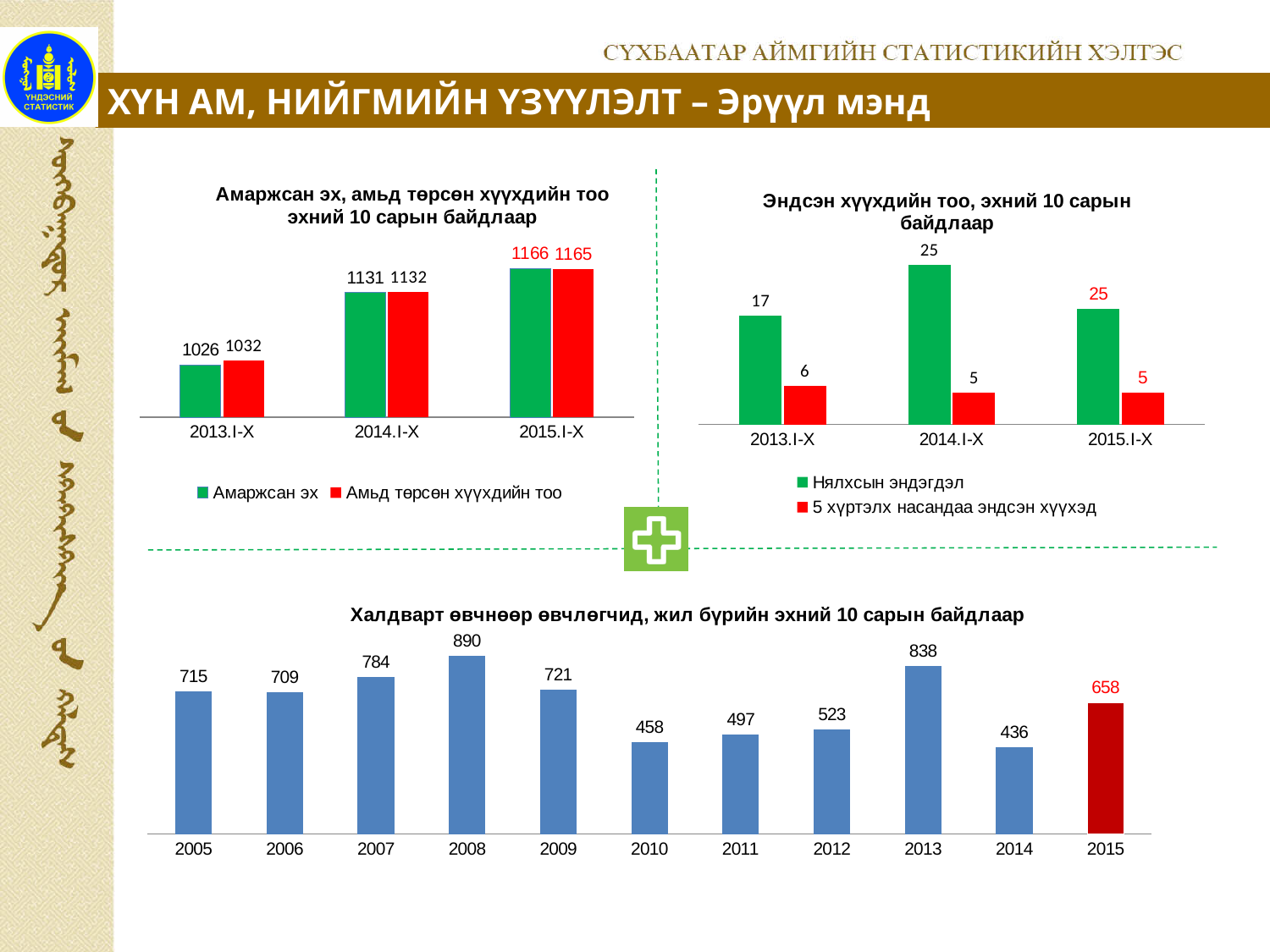
In the bottom chart (Халдварт өвчнөөр өвчлөгчид), what is the value for 2008? 890 In the top-right chart (Эндсэн хүүхдийн тоо), what is the value for Нялхсын эндэгдэл in 2013.I-X? 17 In the bottom chart (Халдварт өвчнөөр өвчлөгчид), how many years are shown on the x axis? 11 In the top-left chart (Амаржсан эх, амьд төрсөн хүүхдийн тоо), what is the value for Амаржсан эх in 2013.I-X? 1026 In the top-right chart (Эндсэн хүүхдийн тоо), what is the value for 5 хүртэлх насандаа эндсэн хүүхэд in 2014.I-X? 5 In the top-left chart (Амаржсан эх, амьд төрсөн хүүхдийн тоо), what is the value for Амьд төрсөн хүүхдийн тоо in 2015.I-X? 1165 What kind of chart is the bottom chart (Халдварт өвчнөөр өвчлөгчид)? Bar chart In the top-left chart (Амаржсан эх, амьд төрсөн хүүхдийн тоо), how many series does the legend list? 2 In the bottom chart (Халдварт өвчнөөр өвчлөгчид), which year has the highest value? 2008 In the bottom chart (Халдварт өвчнөөр өвчлөгчид), which year has the lowest value? 2014 In the top-right chart (Эндсэн хүүхдийн тоо), which period has the lowest value for 5 хүртэлх насандаа эндсэн хүүхэд? 2014.I-X and 2015.I-X (both 5) In the top-left chart (Амаржсан эх, амьд төрсөн хүүхдийн тоо), what is the difference between the Амаржсан эх values for 2015.I-X and 2013.I-X? 140